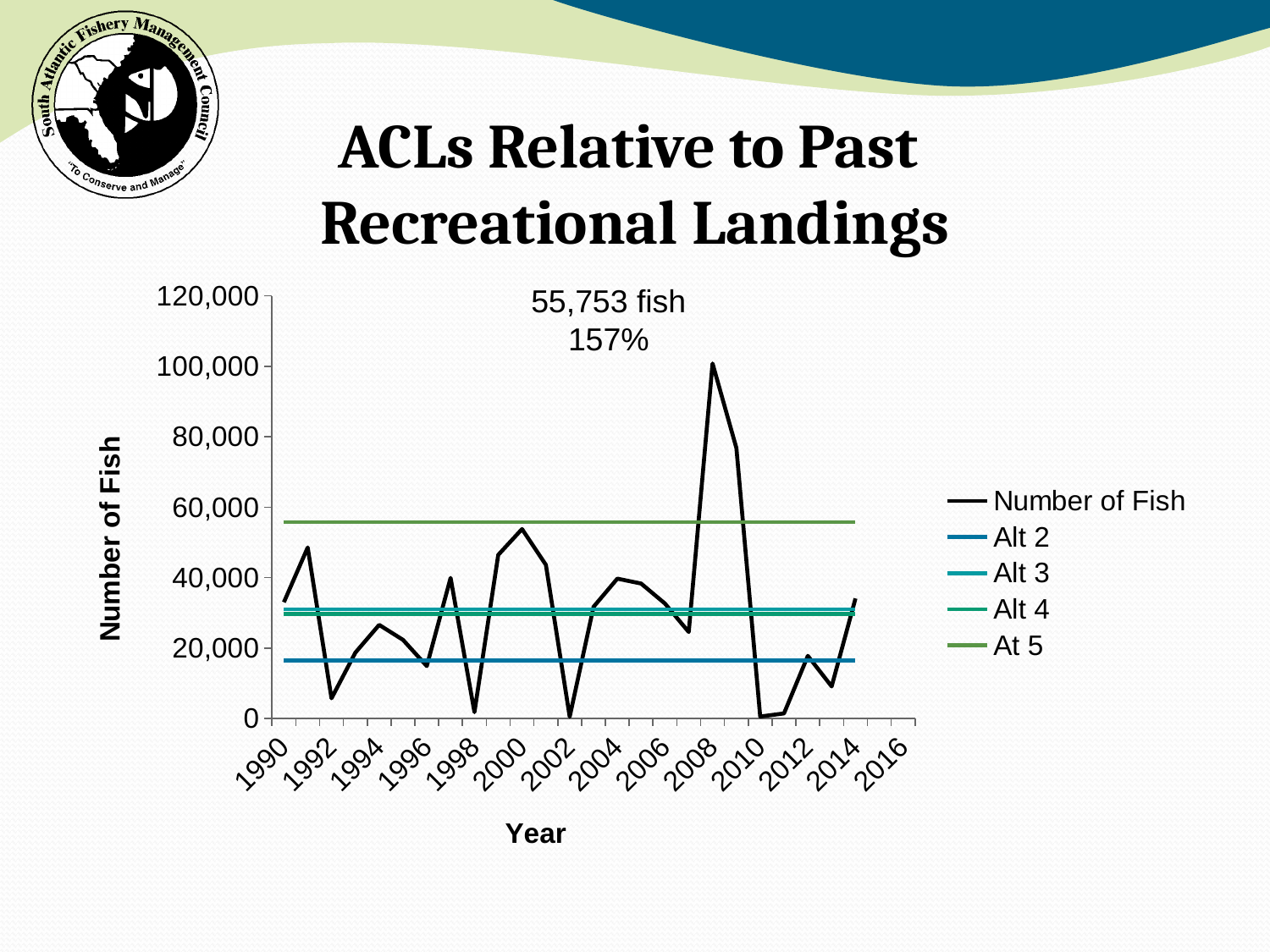
What is the title of the chart's y axis? Number of Fish Which year has the larger Number of Fish value, 2009 or 2001? 2009 What kind of chart is shown on the slide? Line chart Is the Alt 2 line greater or less than 20,000? less What text annotation appears above the chart's plot area? 55,753 fish 157% Is the At 5 line greater or less than 40,000? greater In which year does the Number of Fish series reach its highest value? 2008 Does the Number of Fish series rise or fall from 2009 to 2011? fall Is the Alt 3 line greater or less than 40,000? less How many series does the legend list? 5